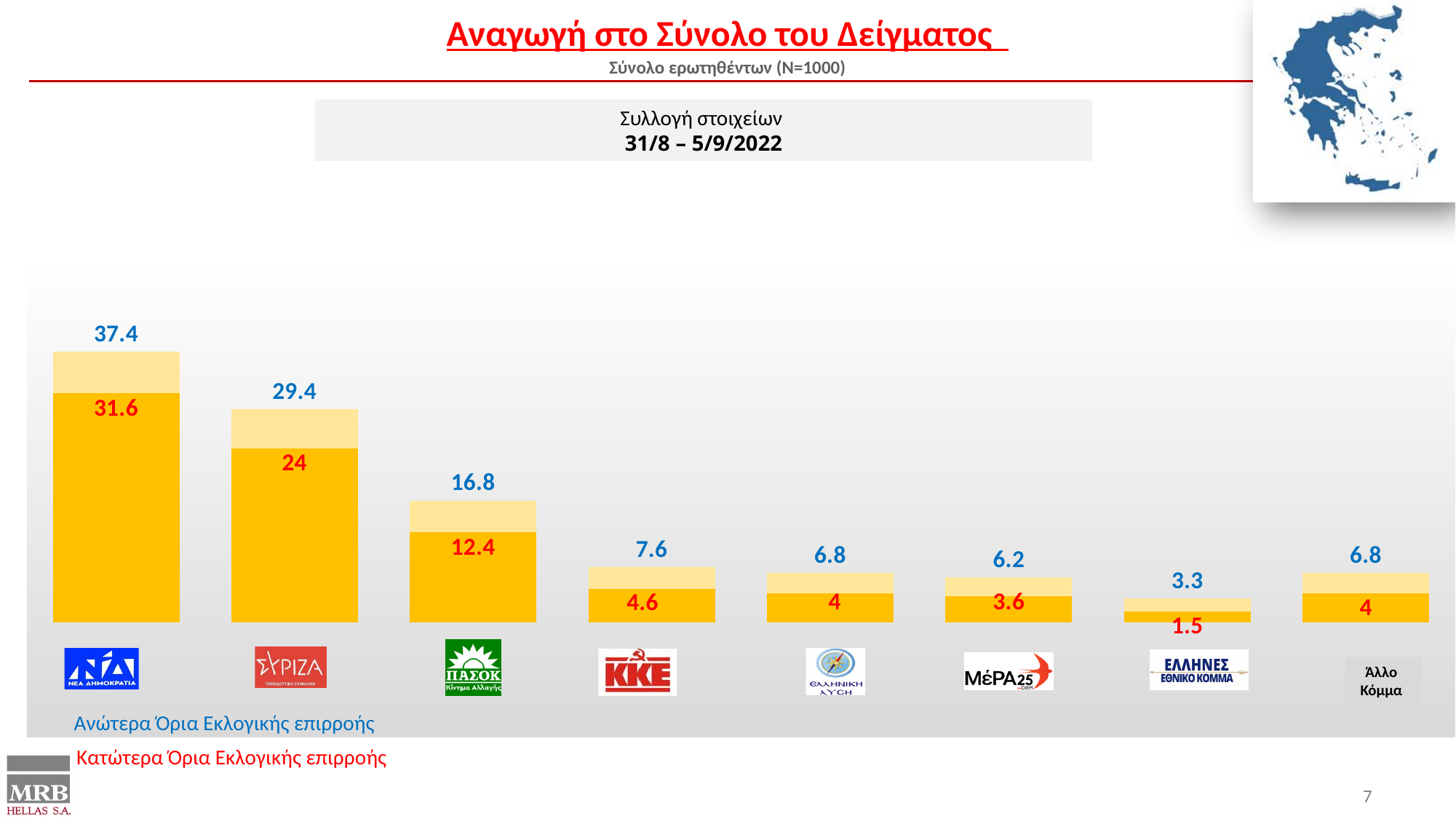
What is the upper limit of electoral influence (Ανώτερα Όρια) shown for ΝΕΑ ΔΗΜΟΚΡΑΤΙΑ? 37.4 Which has a higher upper limit, ΚΚΕ or ΜέΡΑ25? ΚΚΕ How many parties/categories are shown on the chart? 8 What is the lower limit value shown for ΚΚΕ? 4.6 What is the difference between the upper and lower limits for ΝΕΑ ΔΗΜΟΚΡΑΤΙΑ? 5.8 What is the upper limit value shown for ΕΛΛΗΝΕΣ ΕΘΝΙΚΟ ΚΟΜΜΑ? 3.3 What is the lower limit of electoral influence (Κατώτερα Όρια) shown for ΣΥΡΙΖΑ? 24 What is the difference between the upper limits of ΣΥΡΙΖΑ and ΠΑΣΟΚ? 12.6 Which party has the highest upper limit of electoral influence? ΝΕΑ ΔΗΜΟΚΡΑΤΙΑ What kind of chart is shown on the slide? Bar chart Which party has the lowest lower limit of electoral influence? ΕΛΛΗΝΕΣ ΕΘΝΙΚΟ ΚΟΜΜΑ What is the upper limit value shown for ΠΑΣΟΚ? 16.8